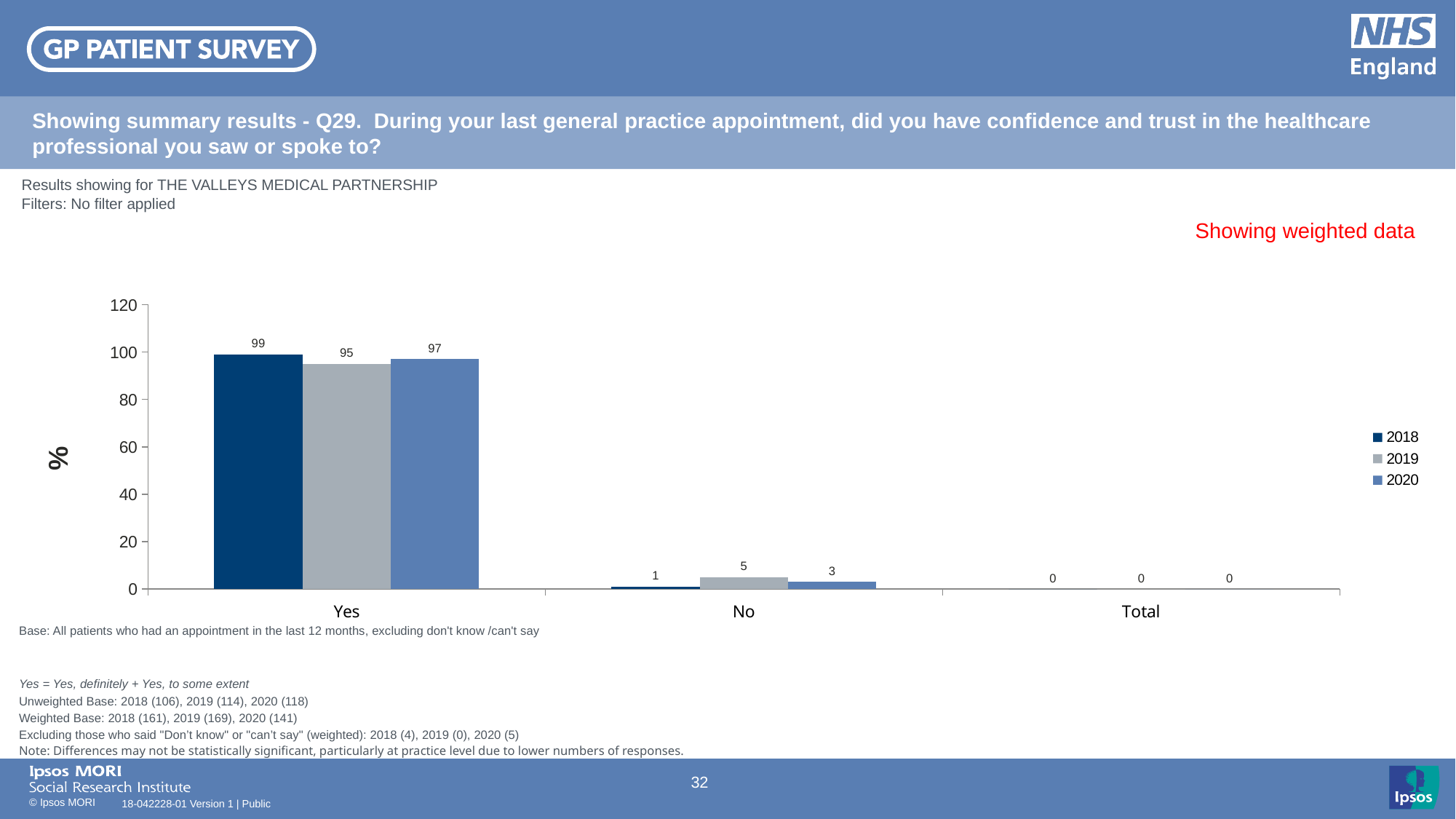
Is the value for 2019 in the Yes category greater or less than 80? greater How many categories are shown on the x axis? 3 What is the value for 2020 in the Yes category? 97 Which year has the lowest value in the Yes category? 2019 What is the value for 2019 in the No category? 5 What is the difference between the 2018 and 2019 values in the Yes category? 4 What is the label on the y axis? % What is the value for 2018 in the Yes category? 99 What kind of chart is shown on the slide? bar chart How many series does the legend list? 3 Which is larger: the 2019 value for No or the 2020 value for No? 2019 Which year has the highest value in the Yes category? 2018